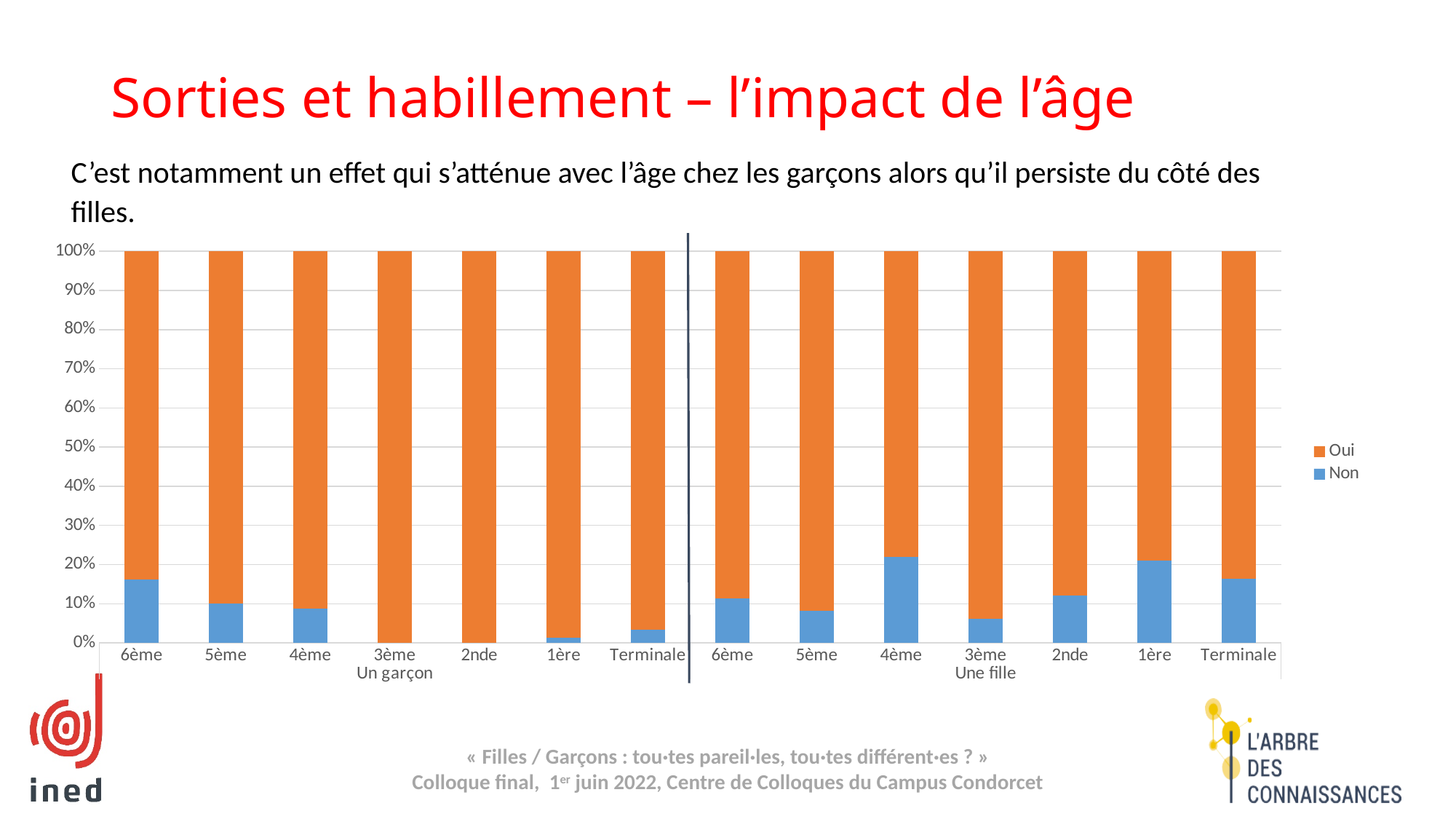
How many series does the chart legend list? 2 Is the 'Non' value for 3ème in the 'Une fille' group greater or less than 10%? less Which colour represents the 'Oui' series in the chart? Orange Which has the larger 'Non' share: 6ème in the 'Un garçon' group or 6ème in the 'Une fille' group? 6ème in the 'Un garçon' group Within the 'Un garçon' group, which class level has the highest 'Non' share? 6ème Is the 'Non' value for 6ème in the 'Un garçon' group greater or less than 10%? greater How many bars are plotted in the chart in total? 14 What kind of chart is shown on the slide? Stacked bar chart Is the 'Non' value for 1ère in the 'Une fille' group greater or less than 10%? greater What are the two series named in the chart legend? Oui and Non How many class levels are shown for the 'Un garçon' group? 7